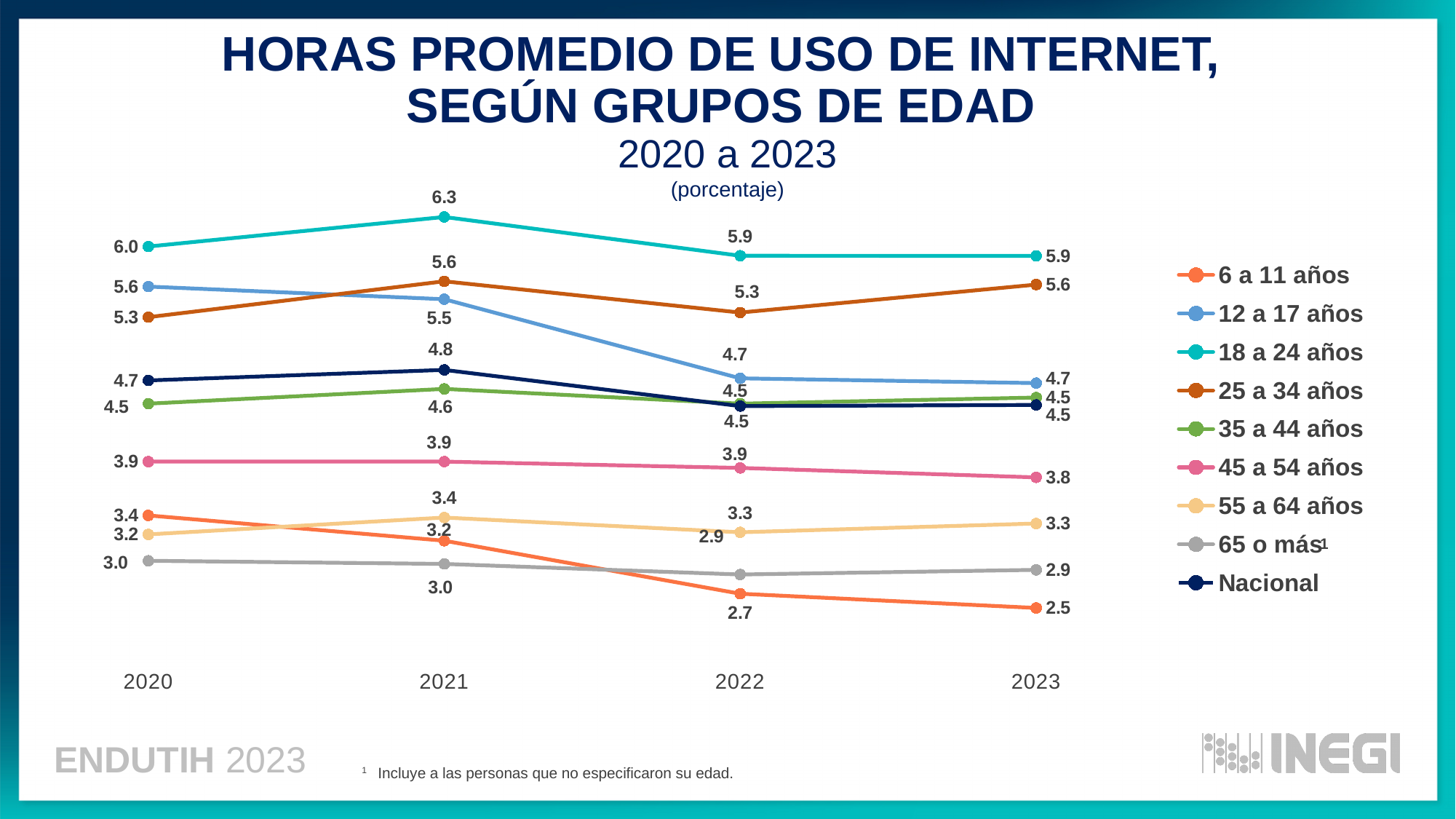
What is the value for the Nacional series in 2020? 4.7 What is the difference between the 18 a 24 años values in 2021 and 2023? 0.4 Which age group has the lowest value in 2023? 6 a 11 años What is the value for the 25 a 34 años series in 2023? 5.6 Which age group has the highest value in 2023? 18 a 24 años How many series does the legend list? 9 What is the value for the 6 a 11 años series in 2023? 2.5 Which is larger in 2022: the value for 12 a 17 años or the value for 25 a 34 años? 25 a 34 años Does the 6 a 11 años series rise or fall from 2020 to 2023? Fall What kind of chart is shown on the slide? Line chart What is the value for the 18 a 24 años series in 2021? 6.3 How many years are shown on the x axis? 4